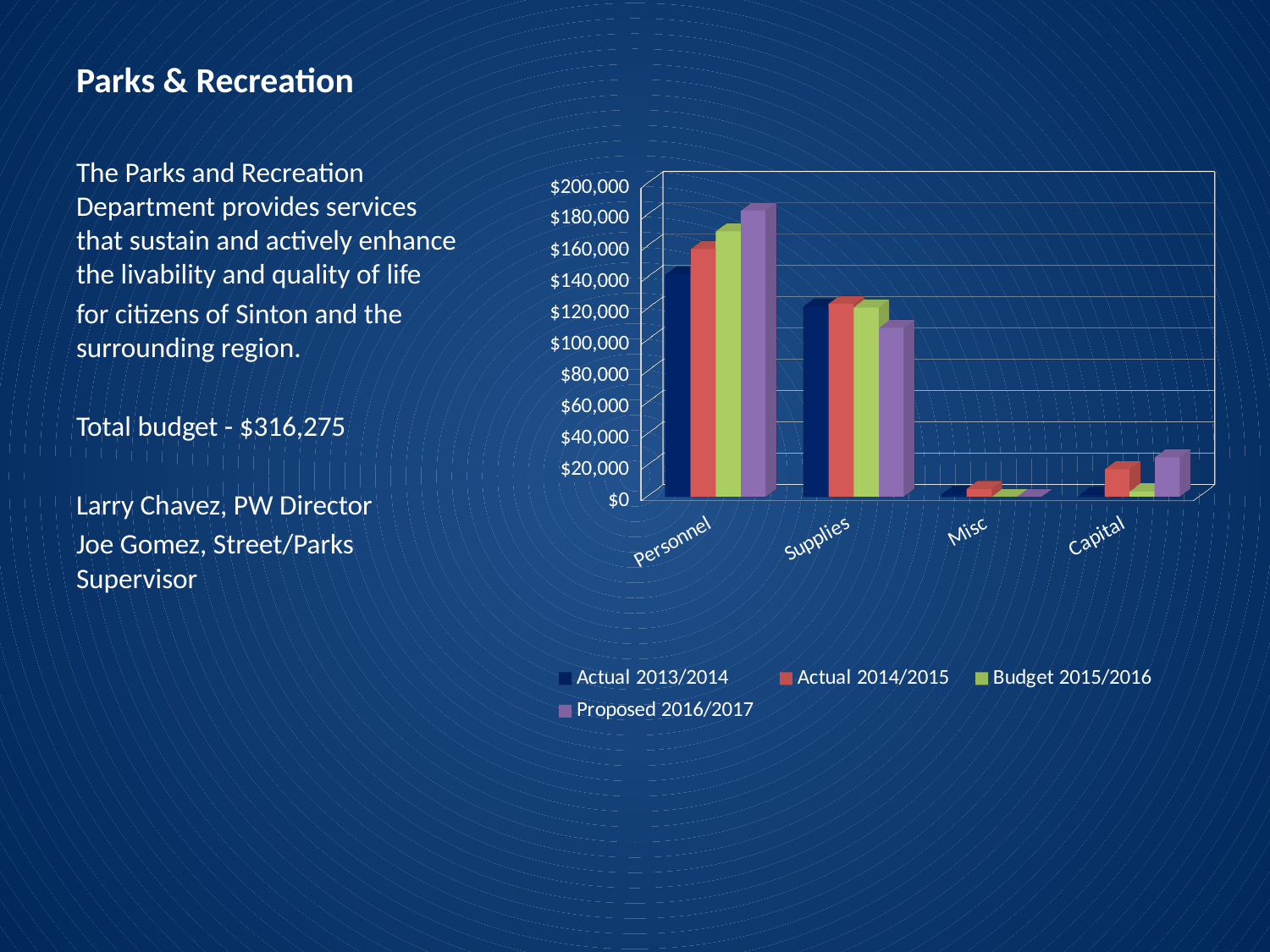
For the Personnel category, do the values rise or fall from Actual 2013/2014 to Proposed 2016/2017? Rise For the Proposed 2016/2017 series, which is larger: Personnel or Supplies? Personnel Which series is shown in purple in the chart's legend? Proposed 2016/2017 How many series does the chart's legend list? 4 Which category has the highest bars in the chart? Personnel What kind of chart is shown on the slide? Bar chart Is the Proposed 2016/2017 value for Capital greater or less than $40,000? less Which category has the lowest bars in the chart? Misc Is the Proposed 2016/2017 value for Personnel greater or less than $160,000? greater Is the Proposed 2016/2017 value for Supplies greater or less than $120,000? less How many categories are shown on the x axis of the chart? 4